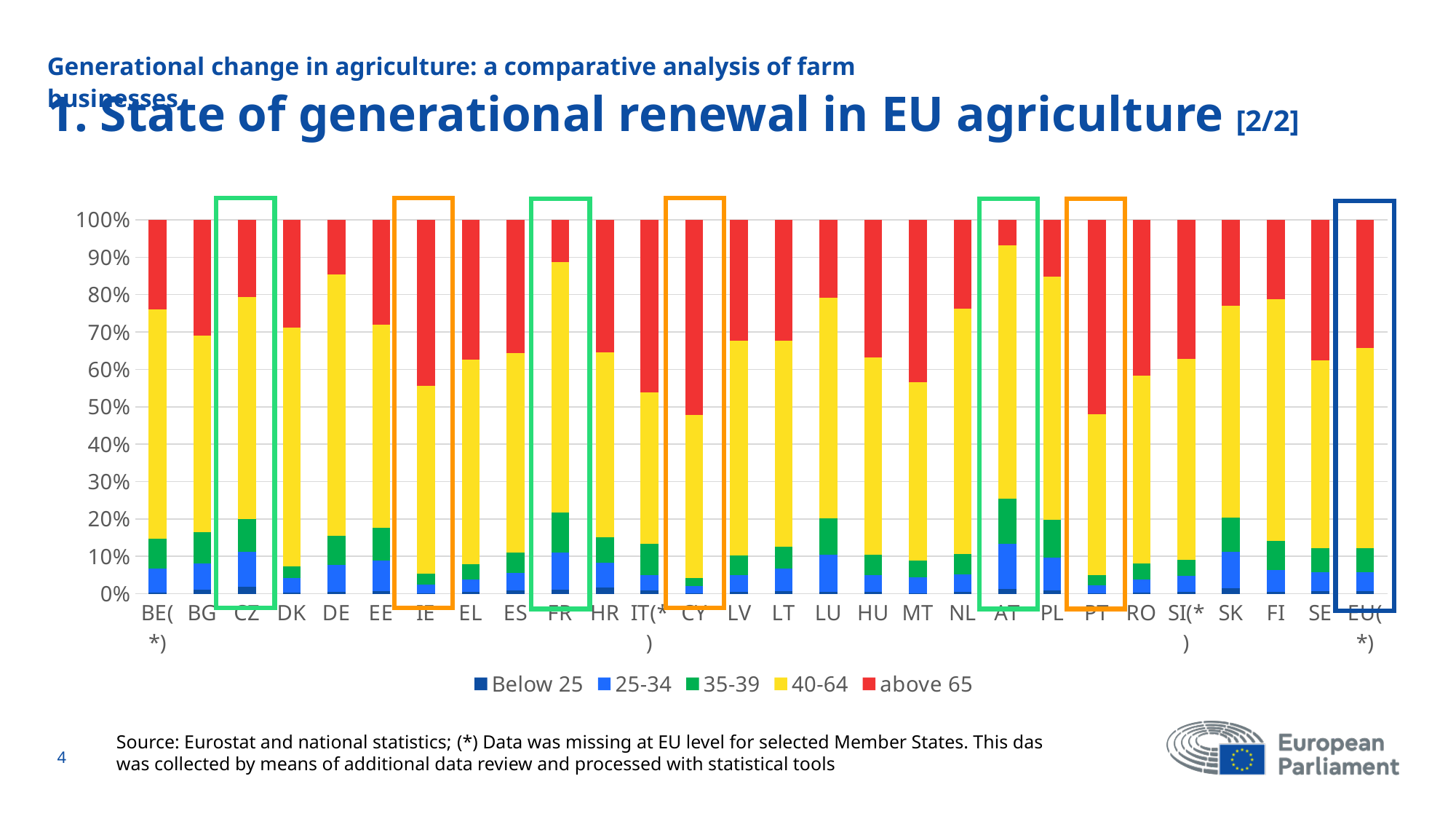
Which category has the smallest 'above 65' segment? AT What kind of chart is shown on the slide? Stacked bar chart How many categories (bars) are plotted along the x axis? 28 For PT, is the top of the '40-64' segment greater or less than 60%? less Is the 'above 65' segment larger for IE or for DE? IE What is the total of each stacked bar, as shown by the top of the bars on the axis? 100% Is the '40-64' segment larger for FR or for IE? FR For AT, is the top of the '35-39' segment greater or less than 20%? greater For FR, is the top of the '40-64' segment greater or less than 80%? greater Is the 'above 65' segment larger for PT or for AT? PT Which legend entry is shown in red? above 65 How many series does the legend list? 5